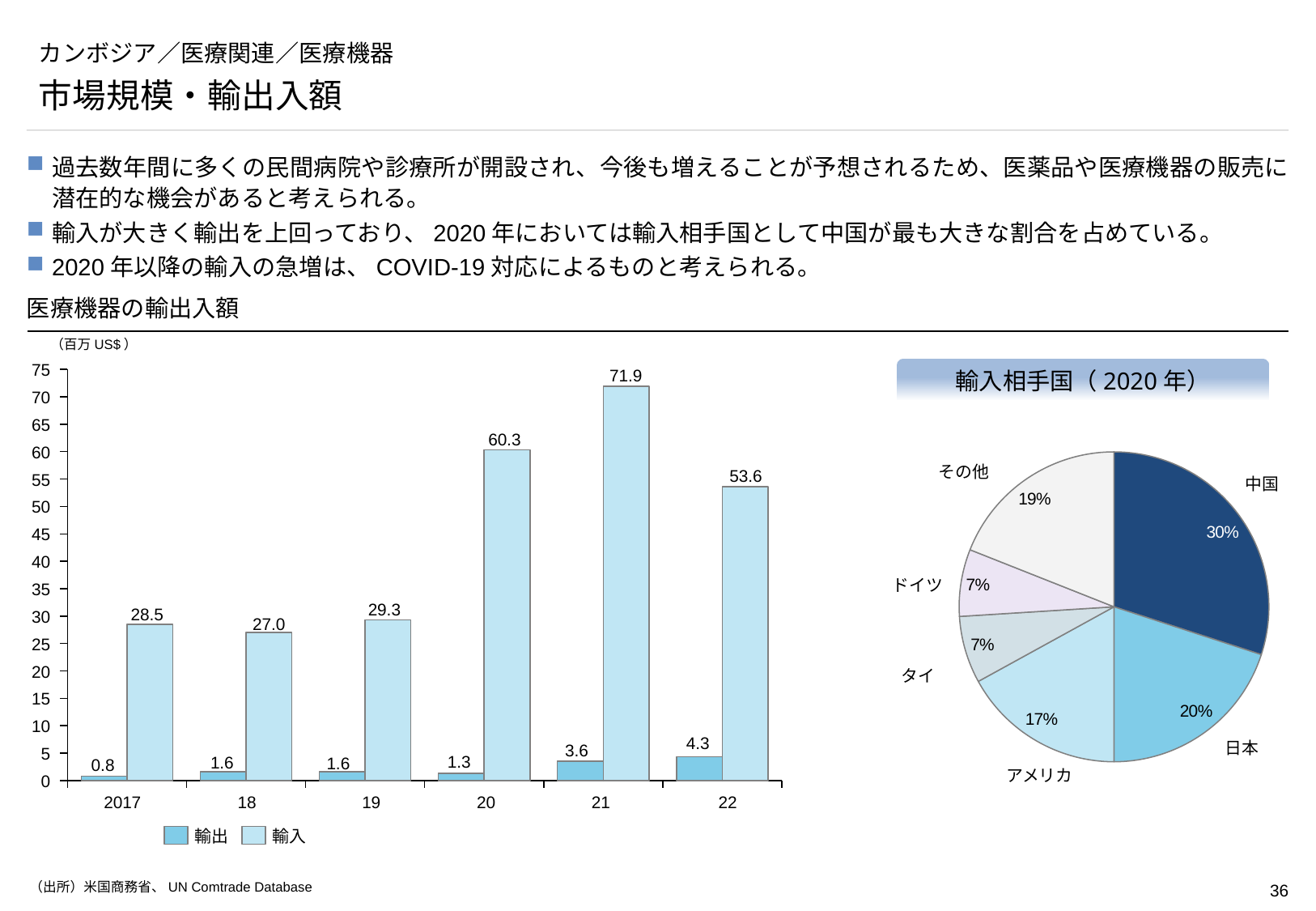
In the bar chart 医療機器の輸出入額, which year has the highest 輸入 value? 21 In the bar chart 医療機器の輸出入額, what is the 輸出 value for 2017? 0.8 In the bar chart 医療機器の輸出入額, how many years are shown on the x axis? 6 In the pie chart 輸入相手国（2020年）, which country has the largest share? 中国 In the bar chart 医療機器の輸出入額, which year has the lowest 輸出 value? 2017 In the bar chart 医療機器の輸出入額, how many series does the legend list? 2 In the pie chart 輸入相手国（2020年）, what share does アメリカ have? 17% What kind of chart is the chart on the right side of the slide? pie chart In the bar chart 医療機器の輸出入額, which is larger: the 輸入 value for 2019 or for 2018? 2019 In the pie chart 輸入相手国（2020年）, what share does 中国 have? 30% In the bar chart 医療機器の輸出入額, what is the difference between the 輸入 values for 2021 and 2022? 18.3 In the bar chart 医療機器の輸出入額, what is the 輸入 value for 2021? 71.9